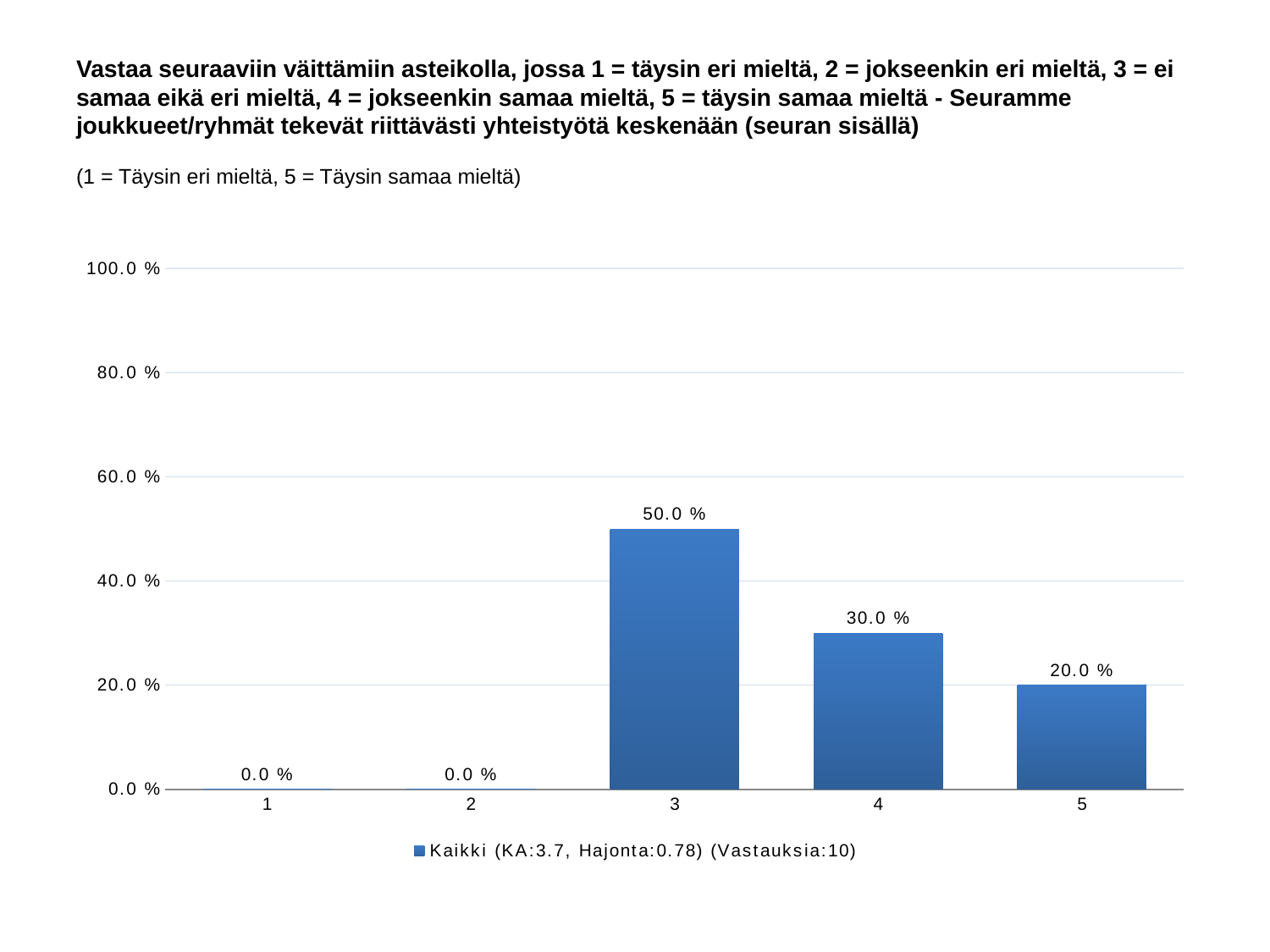
Which is larger, the value for category 4 or the value for category 5? 4 What kind of chart is shown on the slide? bar chart Is the value for category 3 greater or less than 40.0 %? greater How many categories are shown on the x axis? 5 What is the difference between the values for category 3 and category 4? 20.0 % What is the value for category 4? 30.0 % What is the difference between the values for category 4 and category 5? 10.0 % How many series does the legend list? 1 Which category has the highest value? 3 What is the value for category 5? 20.0 % What is the value for category 1? 0.0 % What is the value for category 3? 50.0 %